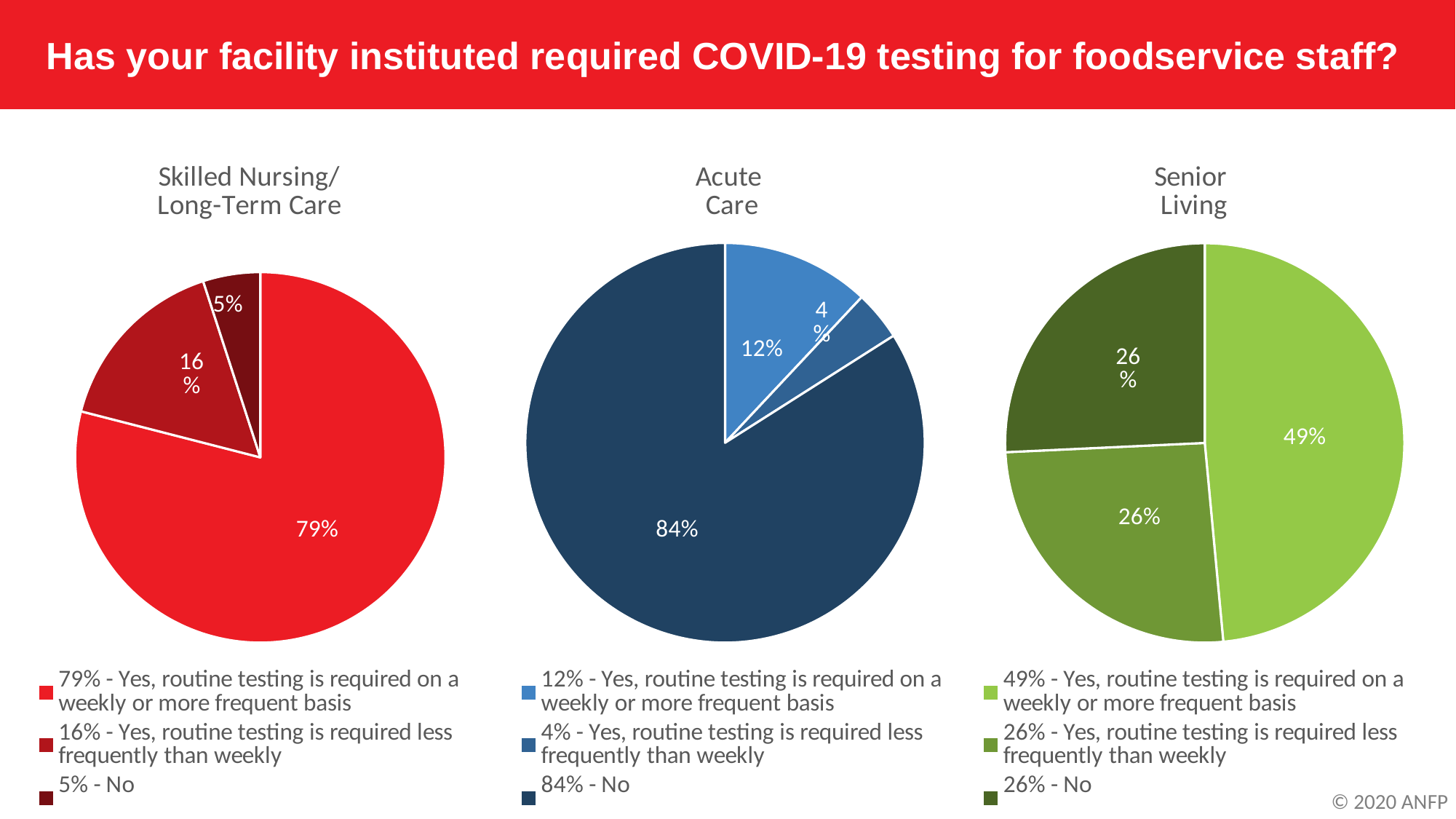
In the Acute Care pie chart, what percentage answered No? 84% Which is larger: the weekly-or-more-frequent testing share in the Skilled Nursing/Long-Term Care chart or in the Senior Living chart? Skilled Nursing/Long-Term Care In the Acute Care pie chart, which response has the largest slice? No In the Senior Living pie chart, what share require routine testing less frequently than weekly? 26% In the Acute Care pie chart, what percentage require routine testing less frequently than weekly? 4% How many pie charts are shown on the slide? 3 What type of chart is used for each facility type on this slide? Pie chart In the Senior Living pie chart, which response has the largest slice? Yes, routine testing is required on a weekly or more frequent basis How many slices does the Senior Living pie chart have? 3 In the Skilled Nursing/Long-Term Care pie chart, which response has the smallest slice? No What is the difference between the No share in the Acute Care chart and the No share in the Skilled Nursing/Long-Term Care chart? 79 percentage points In the Skilled Nursing/Long-Term Care pie chart, what share of facilities require routine testing on a weekly or more frequent basis? 79%